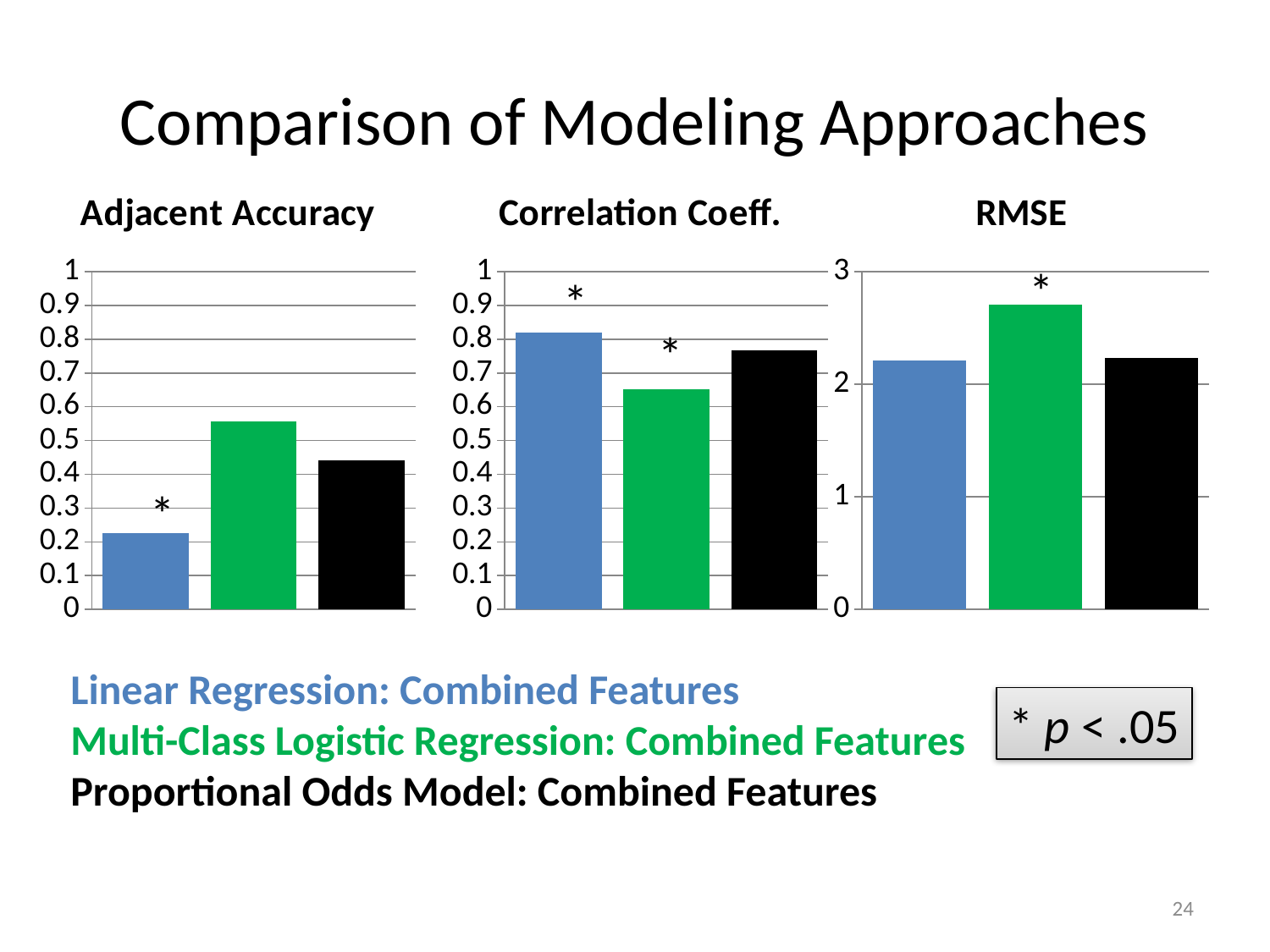
How many bars are plotted in the RMSE chart? 3 In the Correlation Coeff. chart, which modeling approach has the lowest value? Multi-Class Logistic Regression: Combined Features In the Adjacent Accuracy chart, is the value for Multi-Class Logistic Regression greater or less than 0.5? greater In the Adjacent Accuracy chart, is the value for Linear Regression greater or less than 0.3? less In the Adjacent Accuracy chart, which modeling approach has the lowest value? Linear Regression: Combined Features In the Adjacent Accuracy chart, which modeling approach has the highest value? Multi-Class Logistic Regression: Combined Features In the Correlation Coeff. chart, which is larger: the value for Linear Regression or the value for Multi-Class Logistic Regression? Linear Regression: Combined Features In the Correlation Coeff. chart, which modeling approach has the highest value? Linear Regression: Combined Features Which modeling approach is shown by the green bars? Multi-Class Logistic Regression: Combined Features In the RMSE chart, is the value for Multi-Class Logistic Regression greater or less than 2? greater What kind of chart is the Adjacent Accuracy chart? bar chart In the RMSE chart, which modeling approach has the highest value? Multi-Class Logistic Regression: Combined Features